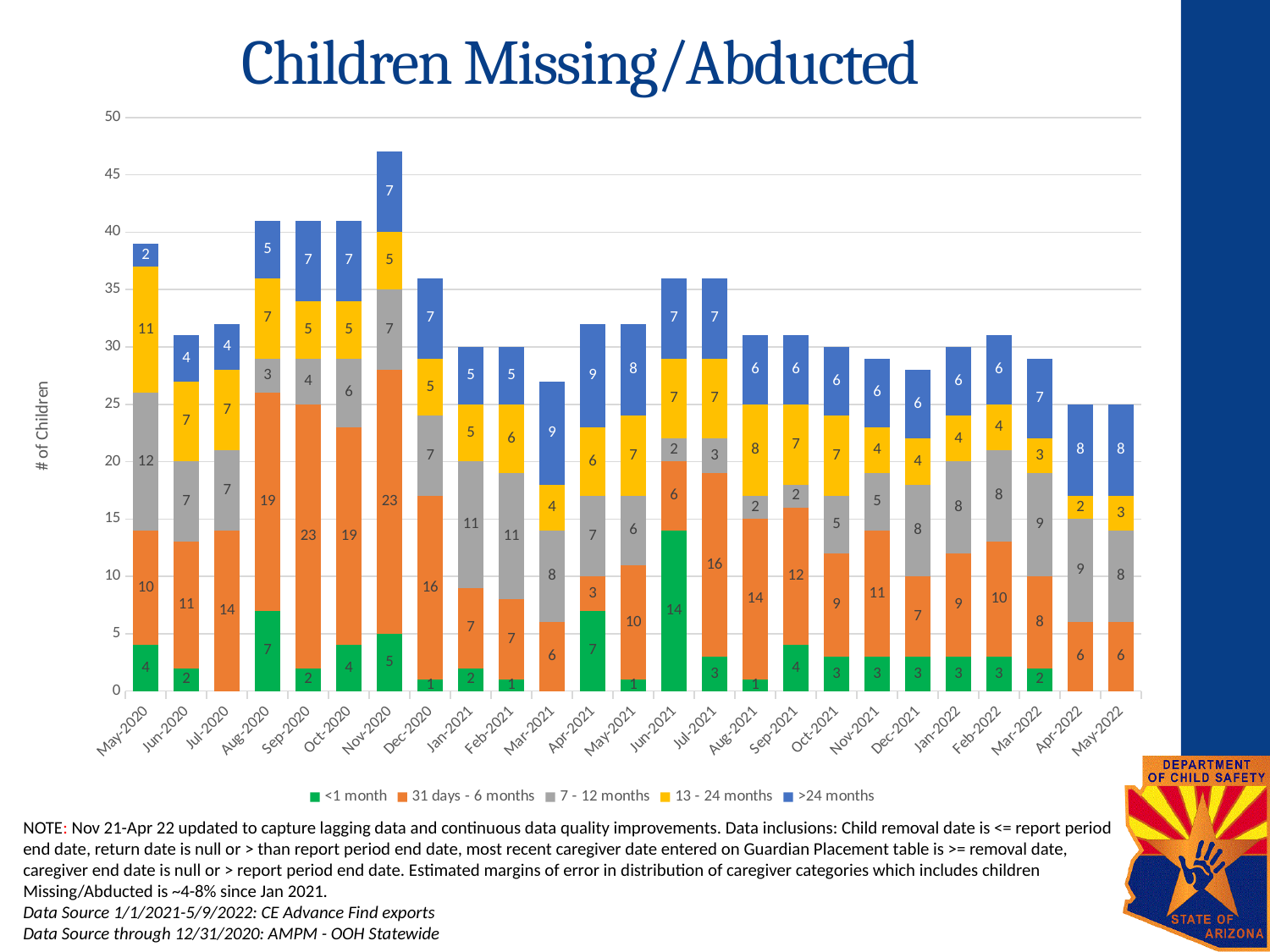
What kind of chart is shown on the slide? Stacked bar chart What is the total of the stacked bar for Nov-2020? 47 What is the value for the 7 - 12 months series in Jan-2021? 11 What is the total of the stacked bar for May-2022? 25 How many series does the legend list? 5 What is the difference between the 13 - 24 months values for May-2020 and Apr-2022? 9 What is the value for the 31 days - 6 months series in Sep-2020? 23 What is the value for the >24 months series in Nov-2020? 7 Which month has the tallest stacked bar? Nov-2020 Which is larger, the 31 days - 6 months value in Jul-2021 or in Dec-2021? Jul-2021 How many months are shown along the x axis? 25 What is the value for the <1 month series in Jun-2021? 14